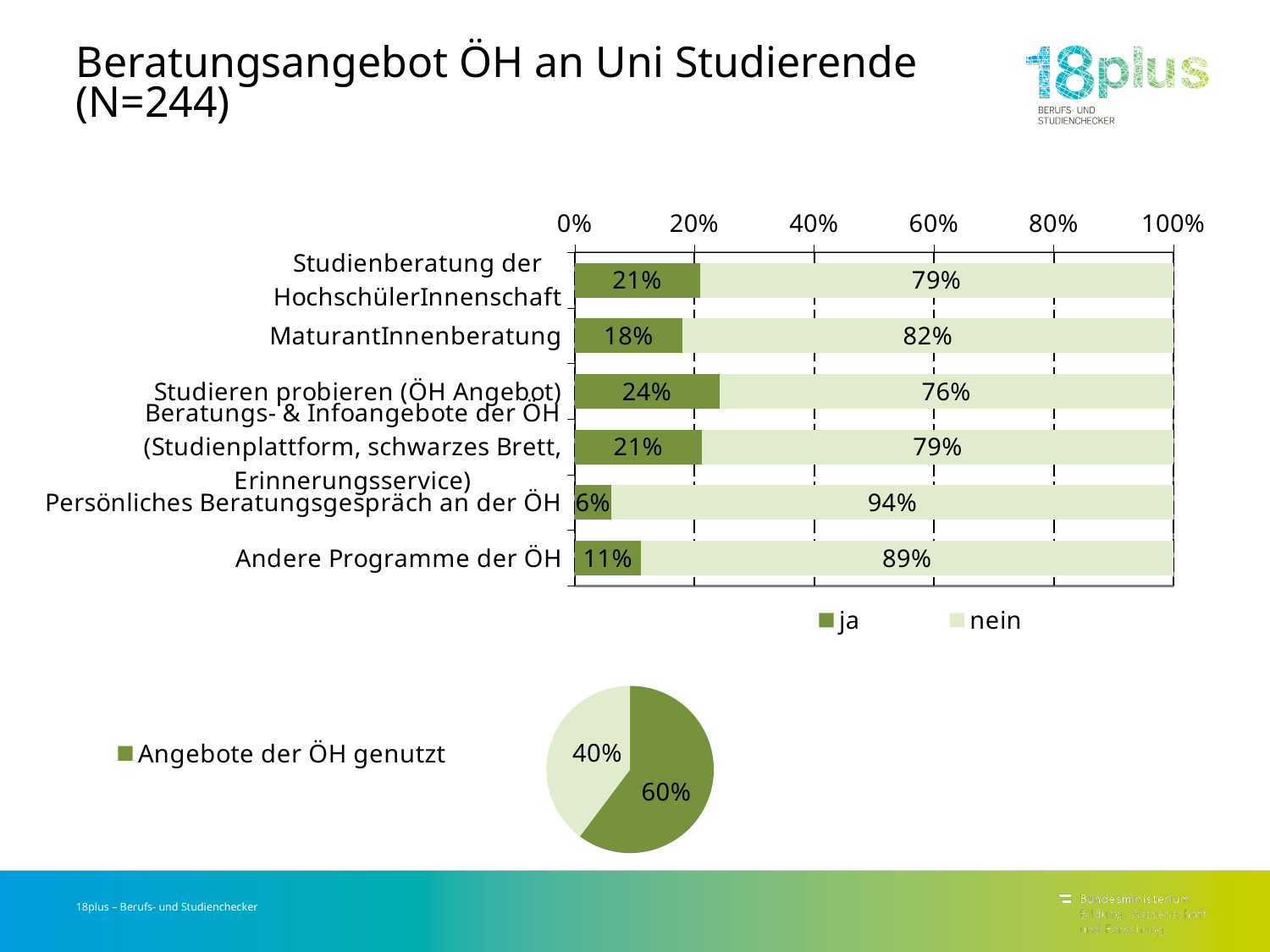
In the stacked bar chart, what is the "ja" value for Studieren probieren (ÖH Angebot)? 24% In the stacked bar chart, which category has the lowest "ja" share? Persönliches Beratungsgespräch an der ÖH In the pie chart at the bottom, what share does the dark green slice (Angebote der ÖH genutzt) represent? 60% In the stacked bar chart, what percentage answered "nein" for Persönliches Beratungsgespräch an der ÖH? 94% In the pie chart at the bottom, what is the value of the light green slice? 40% How many categories does the stacked bar chart show? 6 In the stacked bar chart, which has a larger "ja" share: MaturantInnenberatung or Andere Programme der ÖH? MaturantInnenberatung In the stacked bar chart, which category has the highest "ja" share? Studieren probieren (ÖH Angebot) How many series does the legend of the stacked bar chart list? 2 In the stacked bar chart, what is the difference between the "ja" values for Studieren probieren (ÖH Angebot) and Andere Programme der ÖH? 13% What type of chart is the upper chart on the slide? Stacked bar chart In the stacked bar chart, what percentage answered "ja" for MaturantInnenberatung? 18%